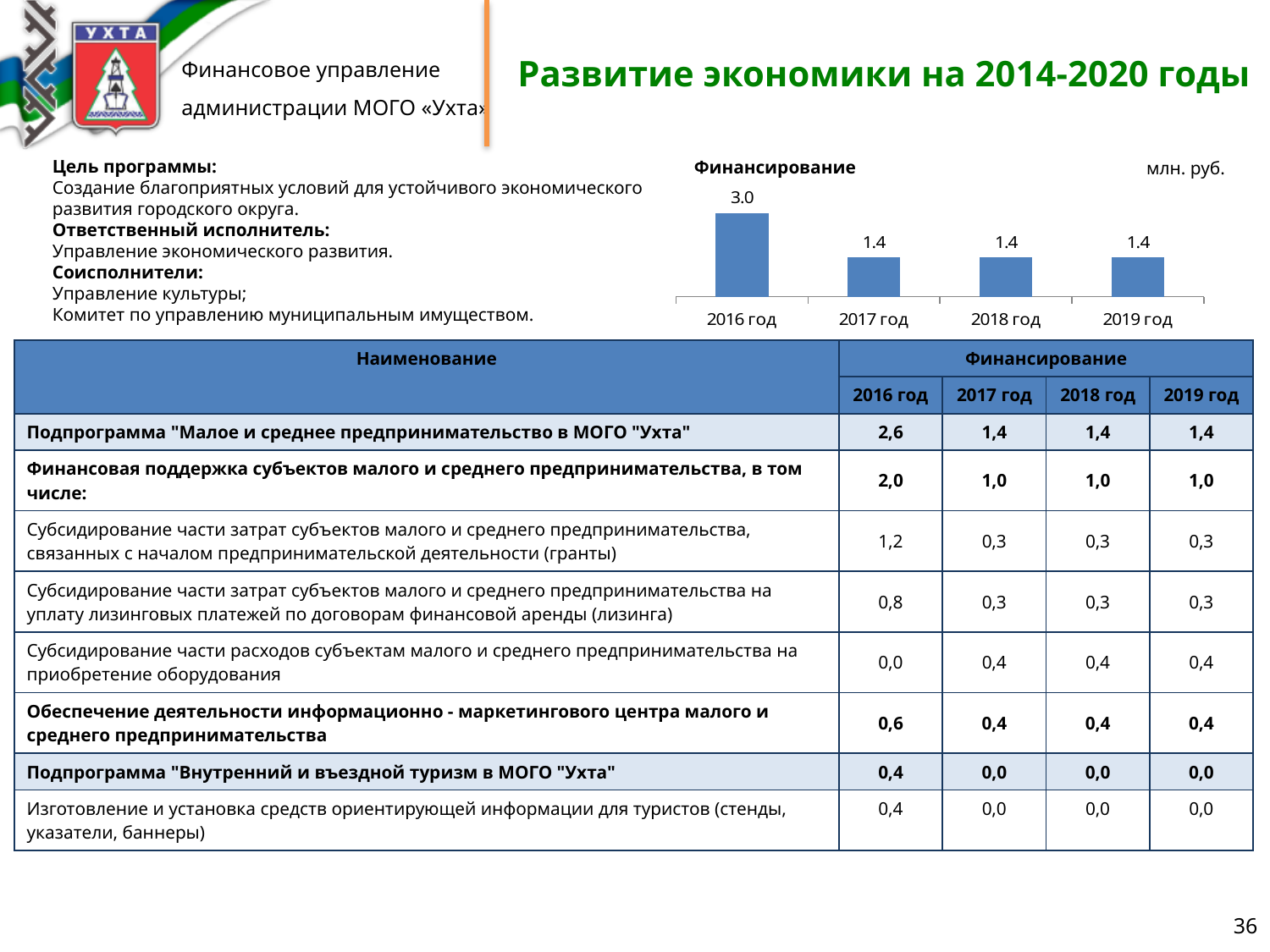
What is the value for 2017 год in the Финансирование chart? 1.4 What kind of chart is the Финансирование chart? bar chart Which year has the highest value in the Финансирование chart? 2016 год Do the values in the Финансирование chart rise or fall from 2016 год to 2017 год? fall What is the value for 2019 год in the Финансирование chart? 1.4 What is the title of the bar chart on the slide? Финансирование Which is larger in the Финансирование chart, the value for 2016 год or the value for 2018 год? 2016 год What is the difference between the values for 2016 год and 2017 год in the Финансирование chart? 1.6 What is the value for 2016 год in the Финансирование chart? 3.0 How many years are shown on the x axis of the Финансирование chart? 4 What unit is indicated for the Финансирование chart? млн. руб. Are the values for 2017 год, 2018 год and 2019 год in the Финансирование chart the same or different? the same